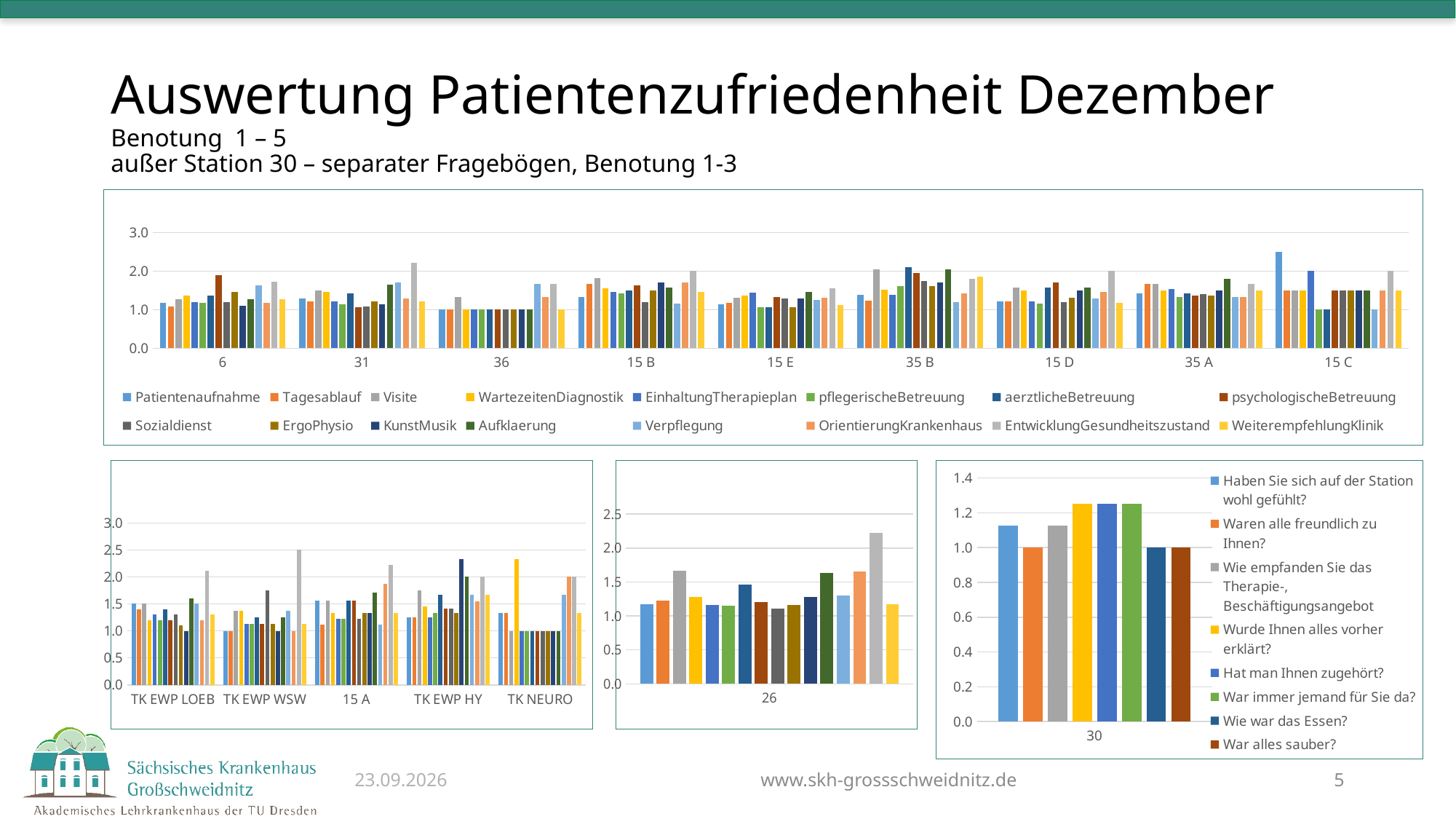
In the large top chart, is the psychologischeBetreuung value for station 6 greater or less than 1.5? greater In the bottom-left chart, is the Visite value for TK EWP WSW greater or less than 2.0? less In the large top chart, is the Patientenaufnahme value for station 15 C greater or less than 2.0? greater How many categories are shown on the x axis of the bottom-left chart? 5 In the bottom-right chart (station 30), which is larger: the value for "Wurde Ihnen alles vorher erklärt?" or the value for "Waren alle freundlich zu Ihnen?"? Wurde Ihnen alles vorher erklärt? How many series does the legend of the large top chart list? 16 How many series does the legend of the bottom-right chart (station 30) list? 8 How many stations (categories) are shown on the x axis of the large top chart? 9 Which station is shown in the bottom-middle chart? 26 What kind of chart is the large chart at the top of the slide? bar chart In the bottom-middle chart (station 26), which series has the highest value? EntwicklungGesundheitszustand